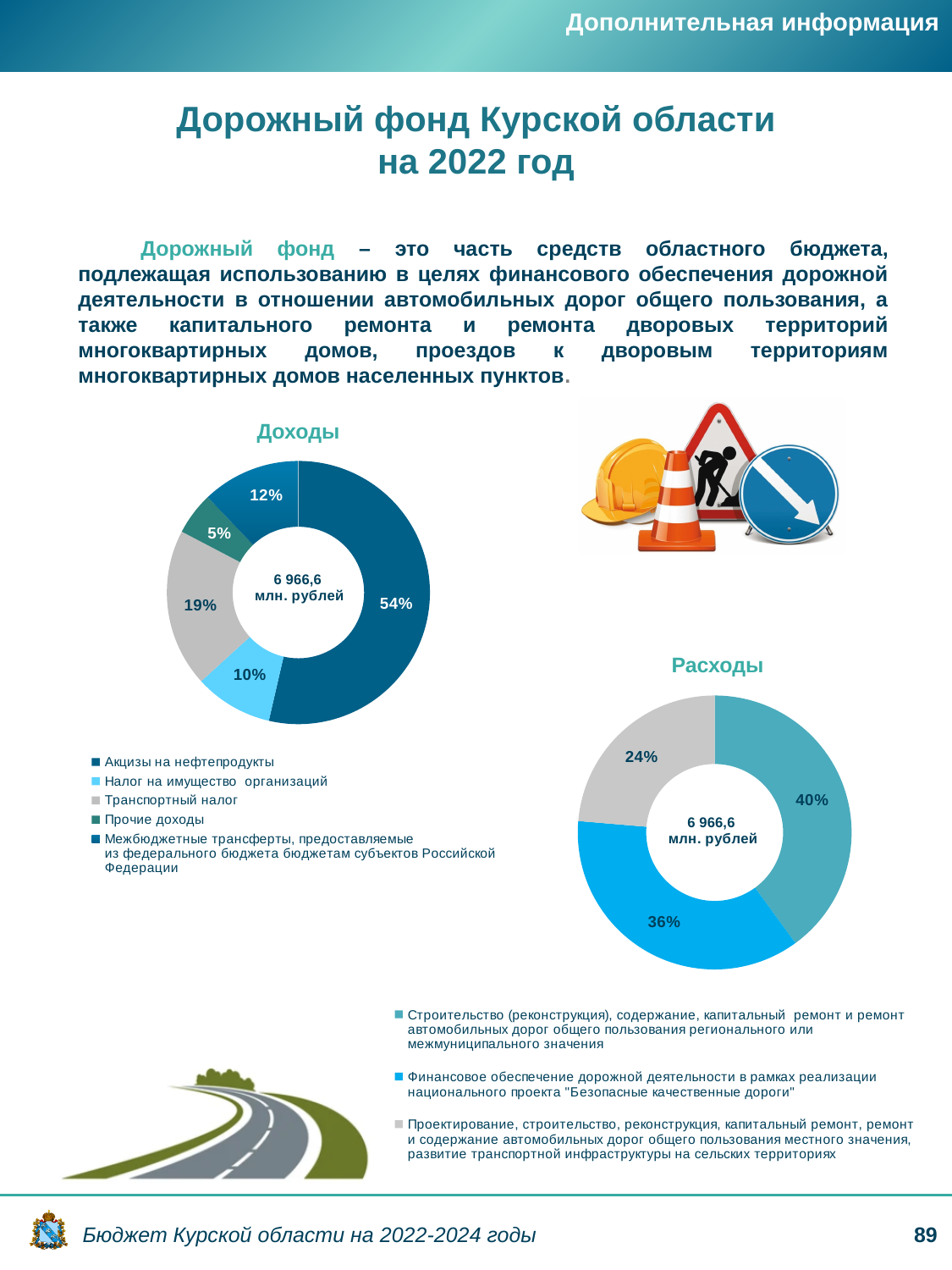
On the Расходы chart, what share is shown for Финансовое обеспечение дорожной деятельности в рамках реализации национального проекта "Безопасные качественные дороги"? 36% On the Доходы chart, what total amount is printed in the centre of the doughnut? 6 966,6 млн. рублей On the Доходы chart, what share is shown for Прочие доходы? 5% On the Доходы chart, what share is shown for Акцизы на нефтепродукты? 54% On the Расходы chart, which category has the largest share? Строительство (реконструкция), содержание, капитальный ремонт и ремонт автомобильных дорог общего пользования регионального или межмуниципального значения On the Доходы chart, how many categories does the legend list? 5 What type of chart is used for Доходы and Расходы? Doughnut (pie) chart On the Доходы chart, which category has the smallest share? Прочие доходы On the Доходы chart, which category has the largest share? Акцизы на нефтепродукты On the Расходы chart, how many slices does the doughnut have? 3 On the Расходы chart, what is the difference in percentage points between the largest slice (40%) and the smallest slice (24%)? 16 percentage points